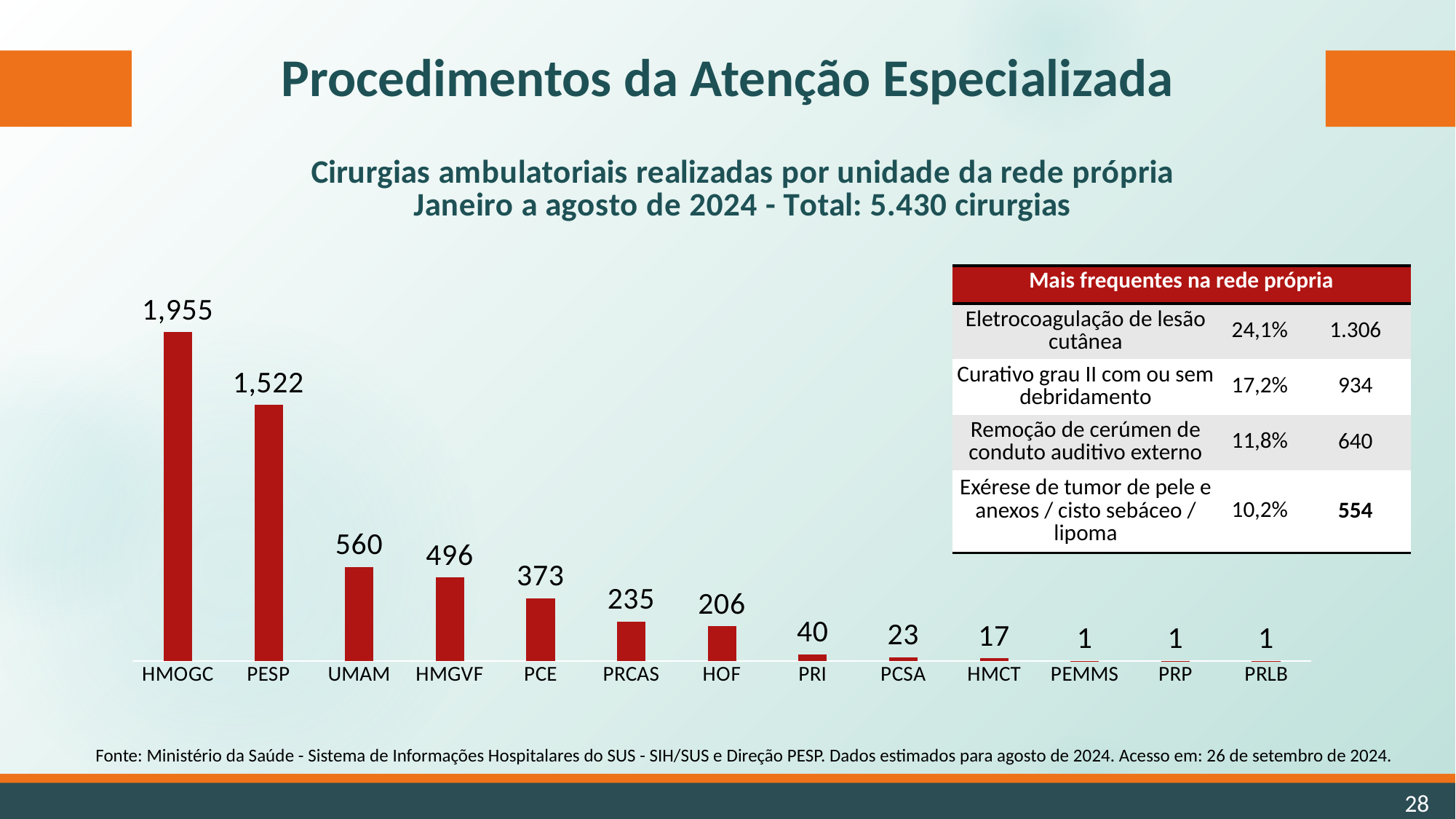
What kind of chart is shown on the slide? bar chart How many units are shown on the x axis of the chart? 13 Which is larger, the value for PCE or the value for PRCAS? PCE What is the difference between the values for HMOGC and PESP? 433 Do the values rise or fall from left to right along the x axis? fall What is the value for PCSA? 23 What is the value for HMOGC? 1,955 What total number of surgeries is stated in the chart title? 5.430 What is the value for UMAM? 560 Which unit has the highest number of ambulatory surgeries? HMOGC What is the value for HOF? 206 What is the difference between the values for UMAM and HMGVF? 64